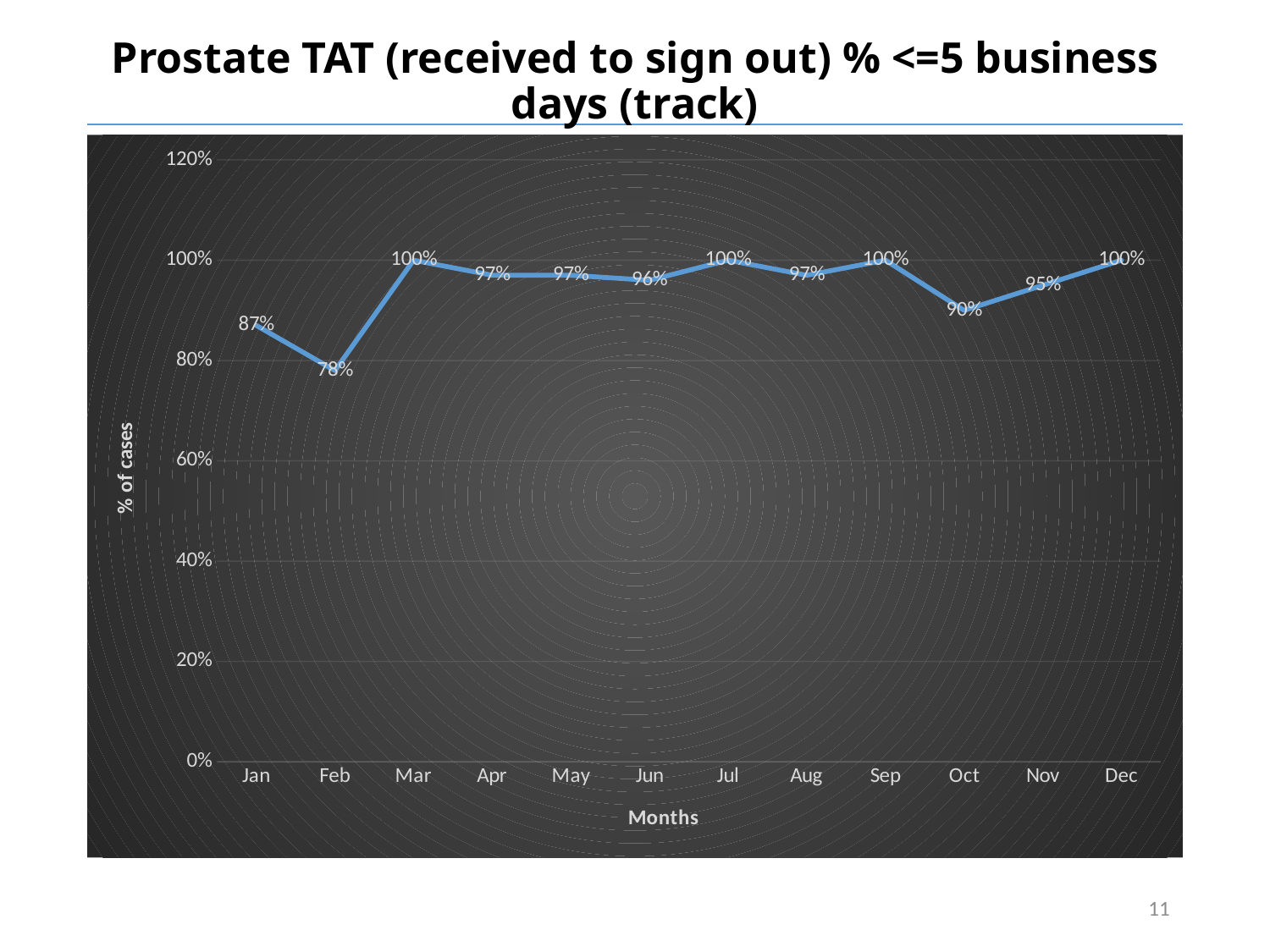
What is the value for Jun? 96% What is the difference between the values for Jan and Oct? 3% Which is larger, the value for Jan or the value for Nov? Nov What is the label of the y axis? % of cases Which month has the lowest value? Feb What is the value for Oct? 90% How many months are plotted on the x axis? 12 What is the value for Feb? 78% What type of chart is shown on the slide? line chart Does the value rise or fall from Jan to Feb? fall What is the difference between the values for Mar and Feb? 22% What is the value for Nov? 95%